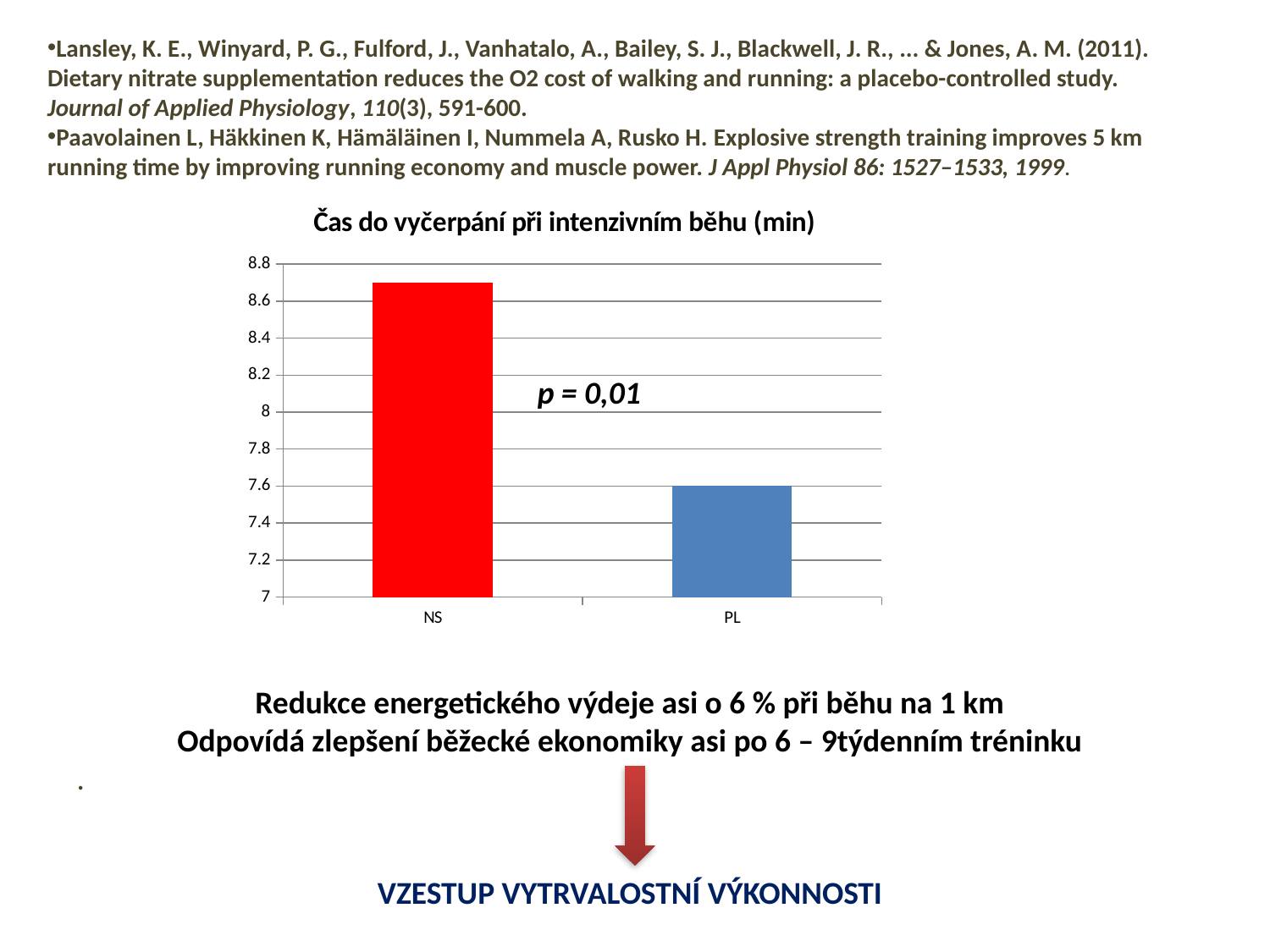
What is the value for PL in the chart? 7.6 What is the title of the chart? Čas do vyčerpání při intenzivním běhu (min) Is the value for NS greater or less than 8.6? greater Which category has the lowest value in the chart? PL Is the value for NS greater or less than 8? greater How many categories are shown on the x axis of the chart? 2 Which category has the highest value in the chart? NS What p-value is annotated on the chart? p = 0,01 Which is larger, the value for NS or the value for PL? NS What kind of chart is shown on the slide? bar chart Is the value for PL greater or less than 8? less